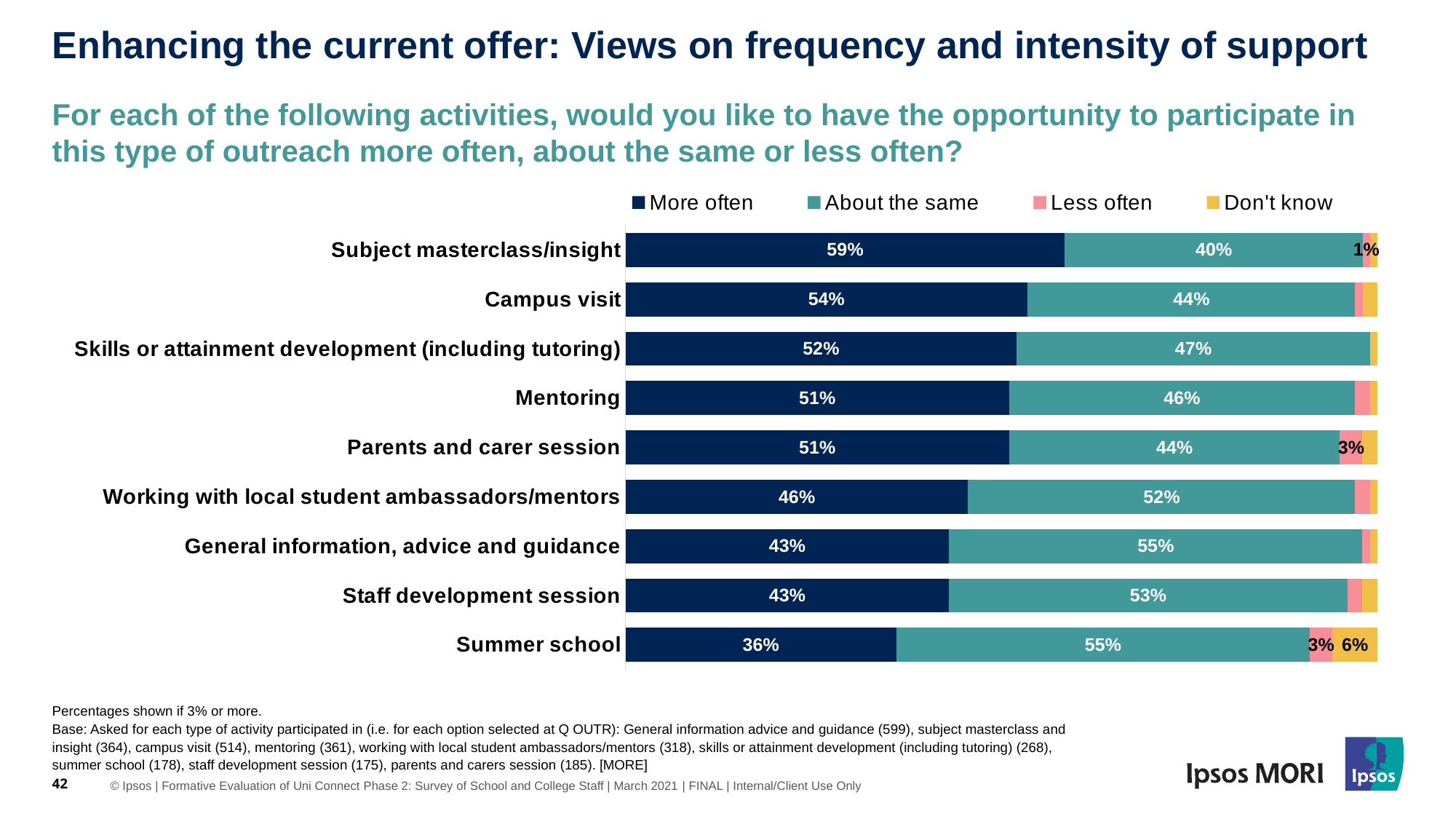
Which activity has the lowest 'About the same' percentage? Subject masterclass/insight How many series does the legend list? 4 What is the 'More often' value for Working with local student ambassadors/mentors? 46% What percentage of respondents said 'More often' for Subject masterclass/insight? 59% Which activity has the highest 'More often' percentage? Subject masterclass/insight What is the difference in percentage points between the 'More often' values for Subject masterclass/insight and Summer school? 23 percentage points What type of chart is shown on the slide? Stacked bar chart What is the 'Don't know' value for Summer school? 6% What is the 'About the same' value for Skills or attainment development (including tutoring)? 47% How many activities are shown in the chart? 9 Which activity has the lowest 'More often' percentage? Summer school Which has a higher 'More often' value: Campus visit or Mentoring? Campus visit